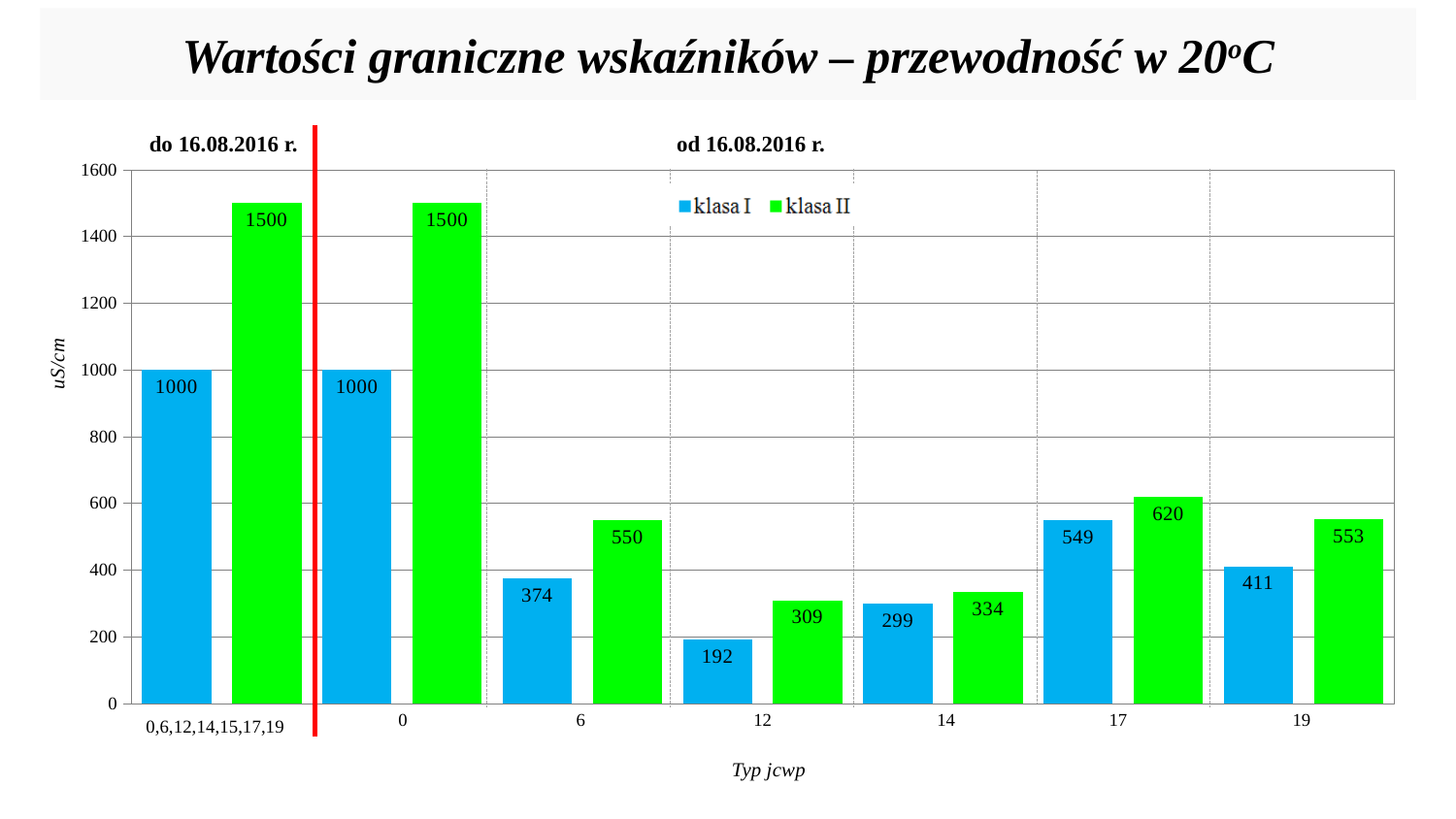
What kind of chart is shown on the slide? bar chart What unit is shown on the vertical axis? uS/cm What is the klasa I value for Typ jcwp 6? 374 Which colour represents klasa II in the chart? green What is the klasa I value for Typ jcwp 12? 192 How many series does the legend list? 2 What is the difference between the klasa II and klasa I values for Typ jcwp 0? 500 What is the difference between the klasa II and klasa I values for Typ jcwp 14? 35 What is the klasa II value for Typ jcwp 17? 620 Which is larger: the klasa I value for Typ jcwp 17 or the klasa I value for Typ jcwp 19? Typ jcwp 17 Which Typ jcwp category in the 'od 16.08.2016 r.' section has the lowest klasa I value? 12 What is the klasa II value for Typ jcwp 19? 553